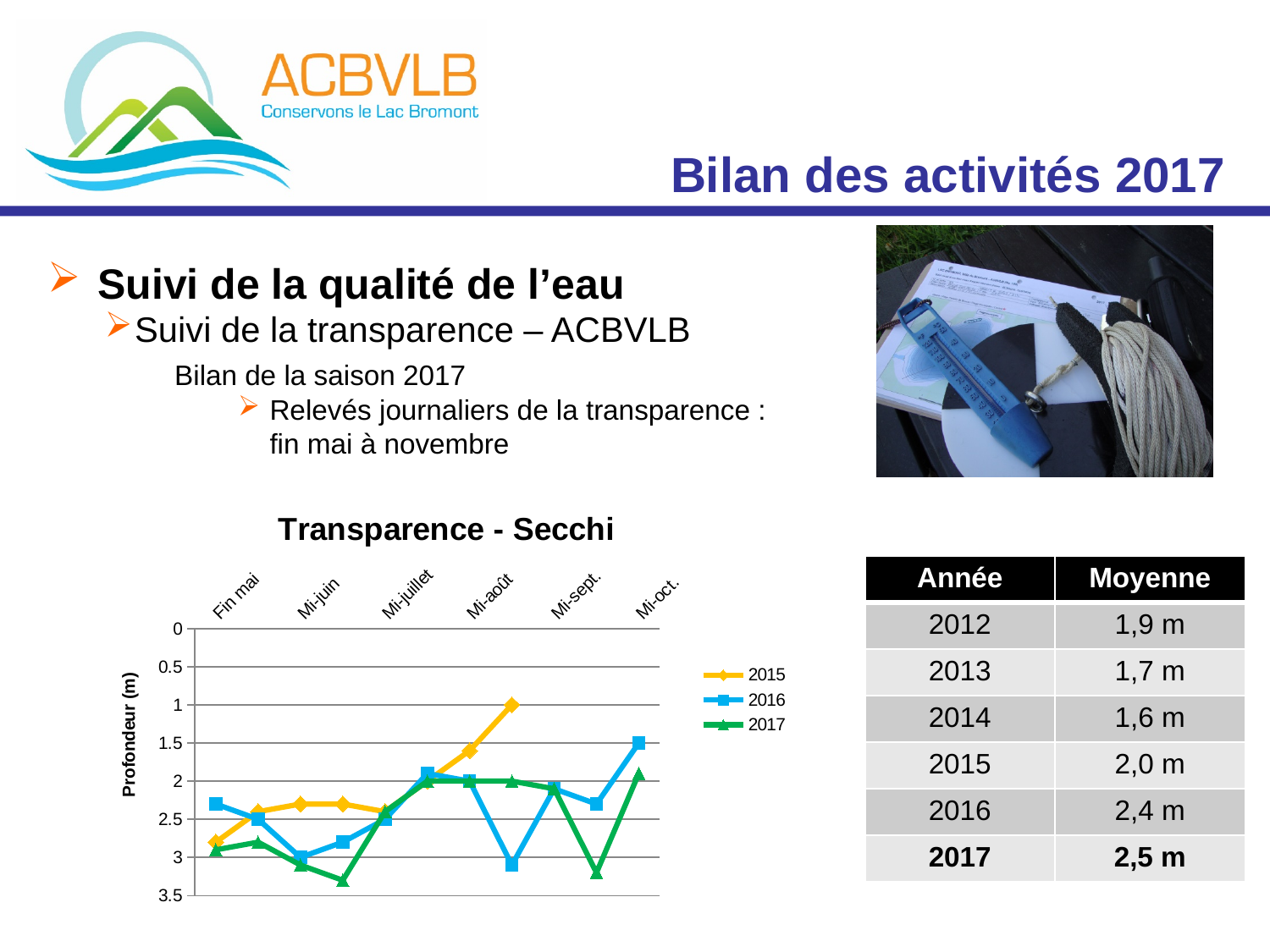
What is the label of the vertical axis of the 'Transparence - Secchi' chart? Profondeur (m) How many series does the legend of the 'Transparence - Secchi' chart list? 3 In the 'Transparence - Secchi' chart, which series has the larger value at Mi-juin, 2015 or 2016? 2016 In the 'Transparence - Secchi' chart, is the value for 2017 at Fin mai greater or less than 2? greater In the 'Transparence - Secchi' chart, which series has the larger value at Fin mai, 2016 or 2017? 2017 In the 'Transparence - Secchi' chart, does the depth value for 2015 increase or decrease between Mi-juillet and Mi-août? decrease In the 'Transparence - Secchi' chart, is the value for 2016 at Fin mai greater or less than 2.5? less In the 'Transparence - Secchi' chart, is the value for 2015 at Fin mai greater or less than 2.5? greater What is the title of the chart on the slide? Transparence - Secchi What type of chart is 'Transparence - Secchi'? line chart How many labelled categories are on the x axis of the 'Transparence - Secchi' chart? 6